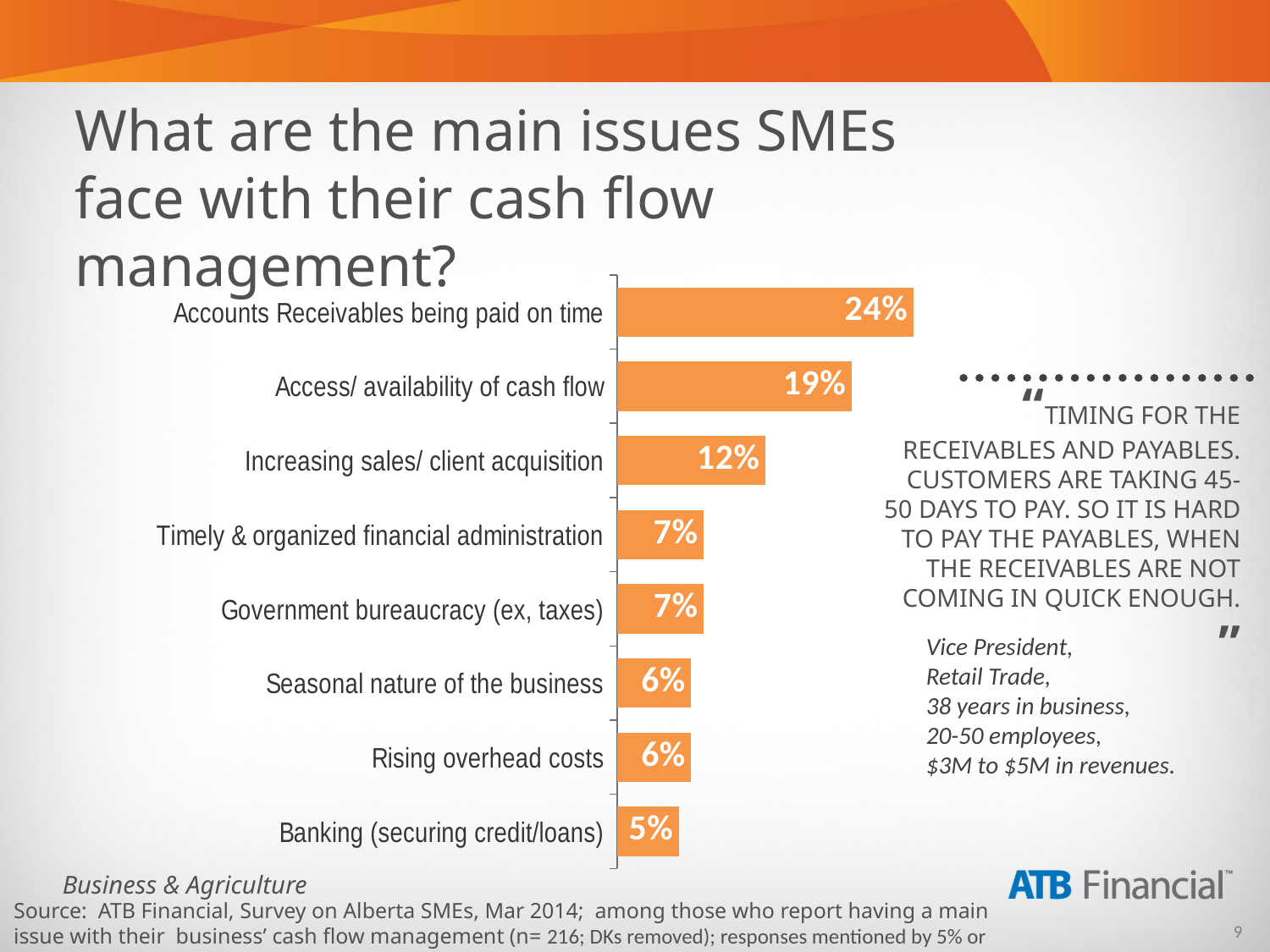
Which issue has the lowest percentage in the chart? Banking (securing credit/loans) What percentage of SMEs cited Accounts Receivables being paid on time as a main cash flow issue? 24% What is the difference between the values for Accounts Receivables being paid on time and Access/ availability of cash flow? 5% Which is larger: the value for Increasing sales/ client acquisition or the value for Timely & organized financial administration? Increasing sales/ client acquisition What is the value for Banking (securing credit/loans)? 5% What colour are the bars in the chart? Orange What is the value for Access/ availability of cash flow? 19% What is the value for Increasing sales/ client acquisition? 12% How many issue categories are shown in the chart? 8 What is the value for Seasonal nature of the business? 6% Which issue has the highest percentage in the chart? Accounts Receivables being paid on time What kind of chart is shown on the slide? Bar chart